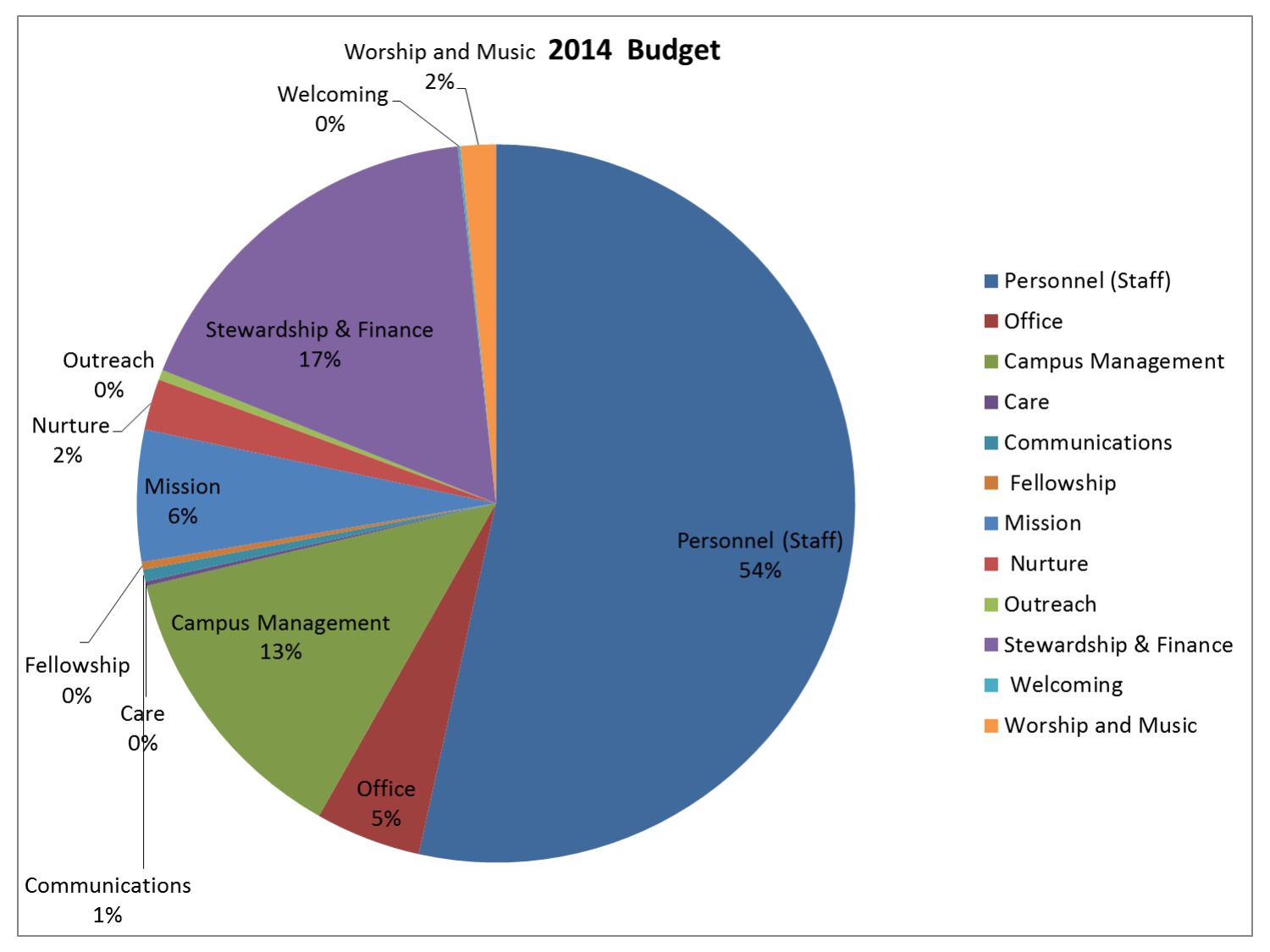
What percentage is shown for Communications? 1% What share of the 2014 Budget goes to Personnel (Staff)? 54% Which is larger, the Office slice or the Mission slice? Mission What kind of chart is shown on the slide? pie chart What percentage is shown for Campus Management? 13% What percentage is shown for Mission? 6% Which category has the largest slice of the pie? Personnel (Staff) What percentage is shown for Stewardship & Finance? 17% What percentage is shown for Worship and Music? 2% How many categories does the legend list? 12 What is the title of the chart? 2014 Budget What is the difference in percentage points between Stewardship & Finance and Campus Management? 4%